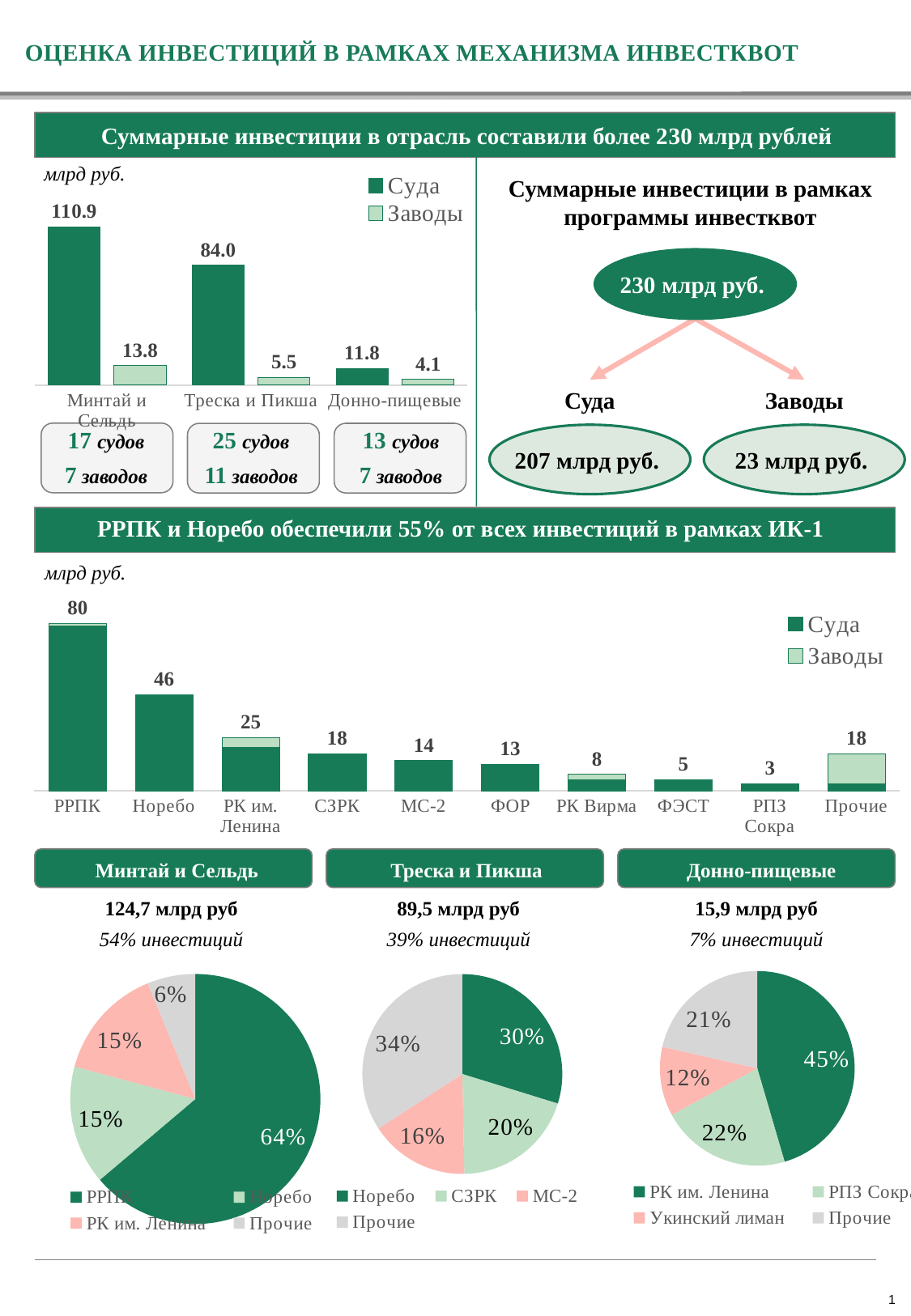
In the middle bar chart (РРПК и Норебо обеспечили 55%...), what is the value for Норебо? 46 In the Донно-пищевые pie chart, what share does РК им. Ленина have? 45% In the top-left bar chart, which category has the lowest Суда value? Донно-пищевые In the top-left bar chart, what is the difference between Суда and Заводы for Донно-пищевые? 7.7 In the top-left bar chart, what is the value of Суда for Минтай и Сельдь? 110.9 How many series does the legend of the top-left bar chart list? 2 In the Треска и Пикша pie chart, what share does Прочие have? 34% In the middle bar chart, what is the difference between the values for РРПК and Норебо? 34 In the middle bar chart, how many categories are shown on the x axis? 10 In the top-left bar chart, what is the value of Заводы for Треска и Пикша? 5.5 In the middle bar chart, which is larger, the value for СЗРК or the value for ФОР? СЗРК In the middle bar chart, which company has the highest value? РРПК